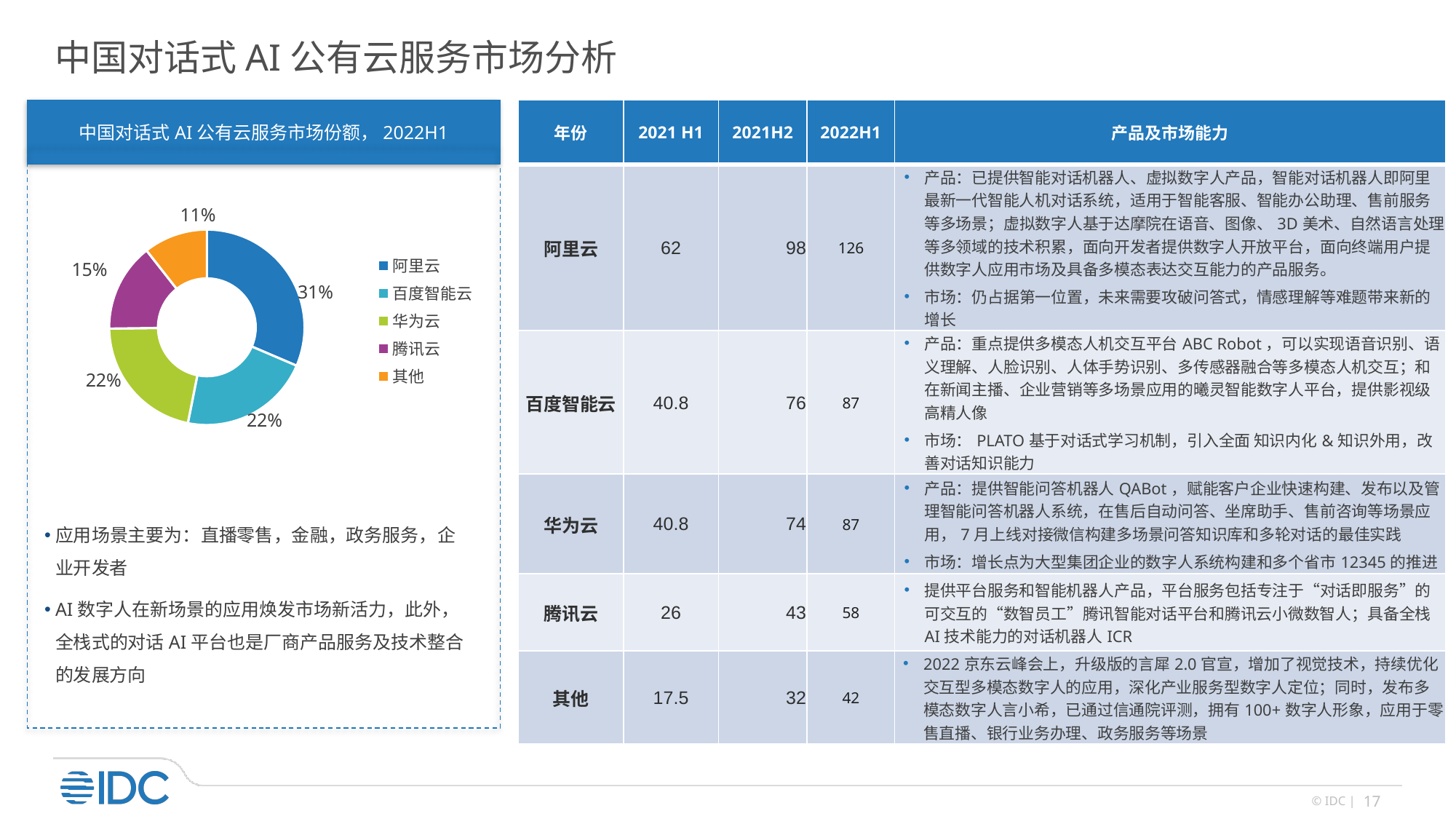
What type of chart is shown on the slide? Pie chart (donut) What is the title of the pie chart? 中国对话式 AI 公有云服务市场份额，2022H1 What is the market share of 其他 in the pie chart? 11% How many categories are shown in the pie chart? 5 How many entries does the pie chart legend list? 5 What is the market share of 腾讯云 in the pie chart? 15% Which has a larger share, 华为云 or 腾讯云? 华为云 What is the market share of 百度智能云 in the pie chart? 22% Which category has the smallest share in the pie chart? 其他 Which category has the largest share in the pie chart? 阿里云 What is the market share of 阿里云 in the pie chart? 31% What is the difference between the shares of 阿里云 and 腾讯云? 16%